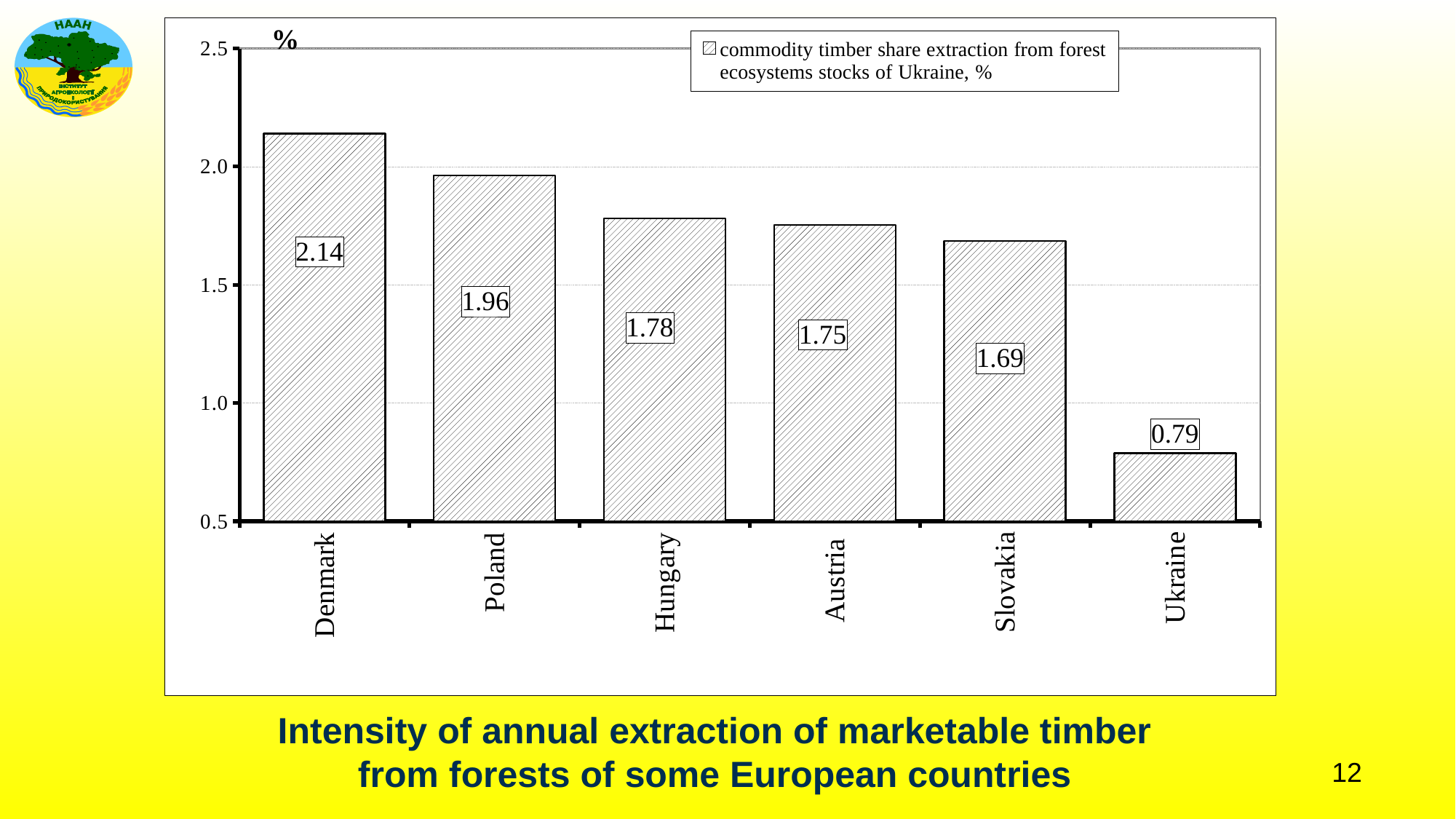
What kind of chart is shown on the slide? bar chart What is the value for Austria? 1.75 What is the value for Ukraine? 0.79 What is the difference between the values for Denmark and Ukraine? 1.35 How many countries are shown on the chart? 6 Is the value for Ukraine greater or less than 1.0? less What is the difference between the values for Poland and Hungary? 0.18 Which is larger, the value for Poland or the value for Slovakia? Poland Which country has the highest value? Denmark What is the value for Denmark? 2.14 Do the values rise or fall from Denmark to Ukraine along the x axis? fall Which country has the lowest value? Ukraine